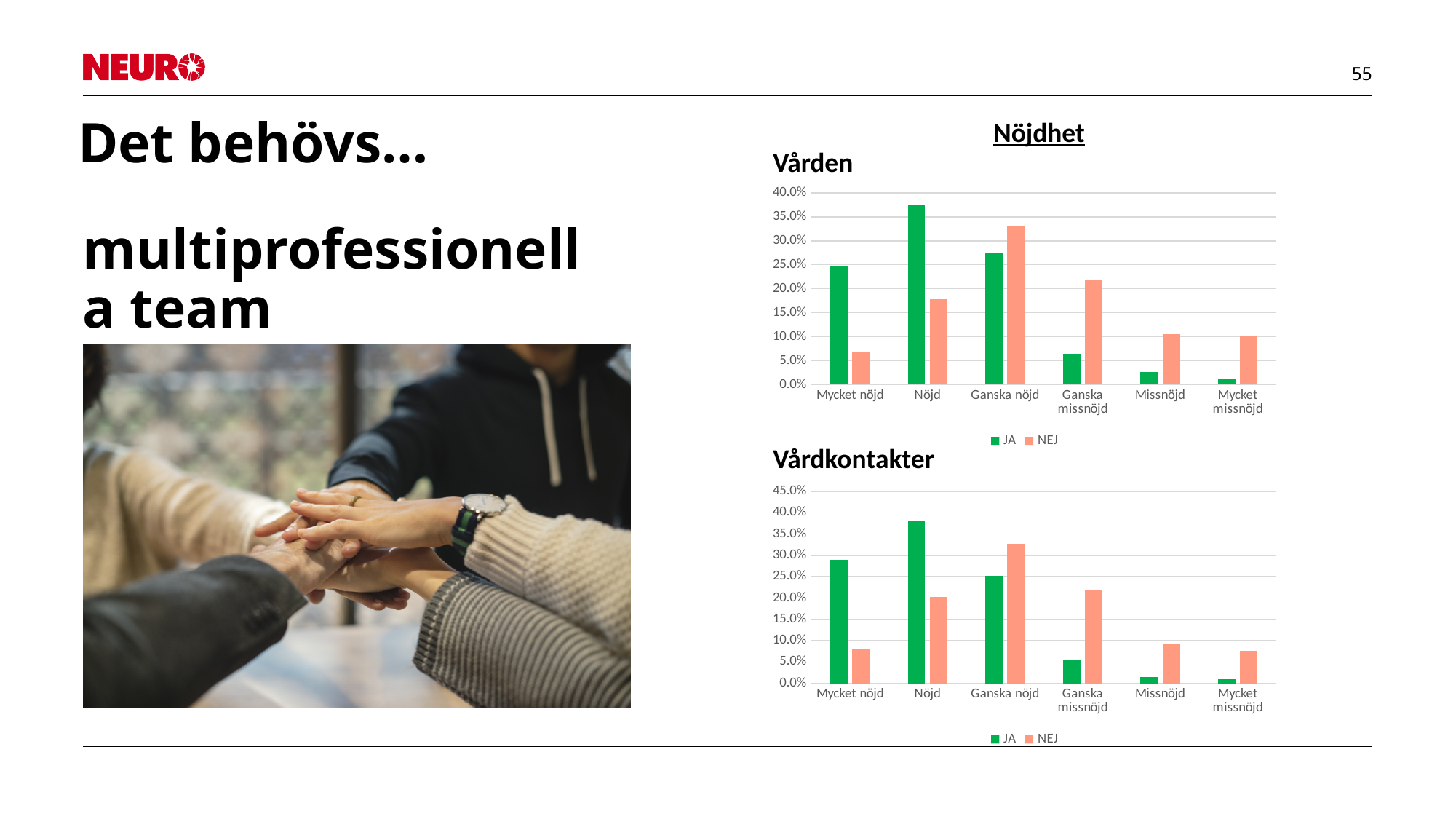
In the Vården chart, is the NEJ value for Mycket nöjd greater or less than 10.0%? less In the Vården chart, which category has the highest NEJ value? Ganska nöjd How many categories are shown on the x axis of the Vårdkontakter chart? 6 In the Vårdkontakter chart, which category has the highest NEJ value? Ganska nöjd How many series does the legend of the Vården chart list? 2 In the Vårdkontakter chart, which category has the highest JA value? Nöjd In the Vården chart, is the JA value for Nöjd greater or less than 35.0%? greater In the Vården chart, which category has the lowest JA value? Mycket missnöjd In the Vårdkontakter chart, is the JA value for Mycket nöjd greater or less than 25.0%? greater In the Vårdkontakter chart, which is larger for Mycket nöjd, JA or NEJ? JA In the Vården chart, which is larger for Ganska missnöjd, JA or NEJ? NEJ